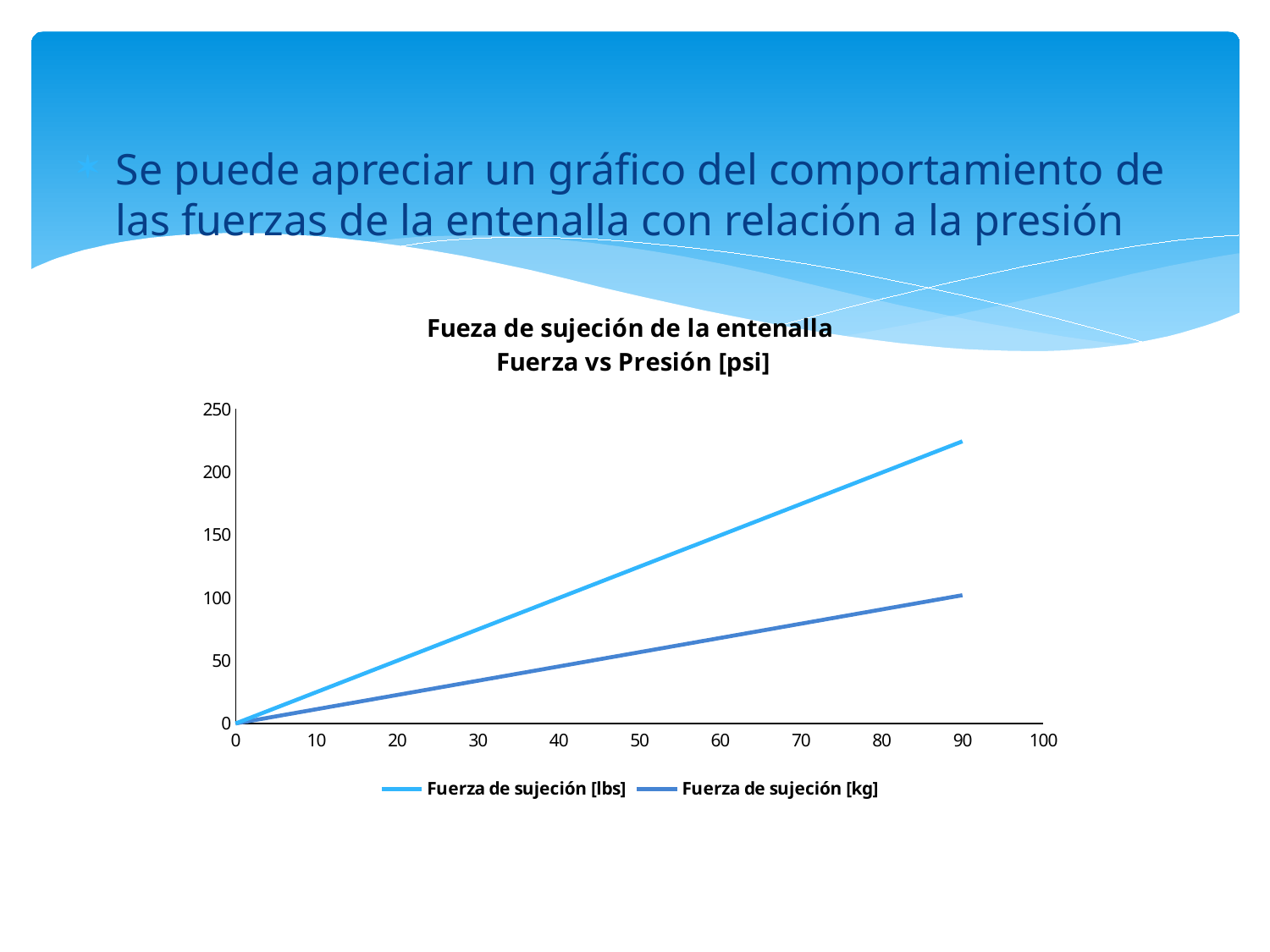
What is the value of Fuerza de sujeción [lbs] at 0 psi? 0 Do the values of Fuerza de sujeción [kg] rise or fall as pressure increases along the x axis? rise Which series is drawn in the lighter blue line? Fuerza de sujeción [lbs] What kind of chart is shown on the slide? line chart Is the value of Fuerza de sujeción [lbs] at 90 psi greater or less than 200? greater Is the value of Fuerza de sujeción [kg] at 50 psi greater or less than 100? less Do the values of Fuerza de sujeción [lbs] rise or fall as pressure increases along the x axis? rise At 90 psi, which series has the larger value, Fuerza de sujeción [lbs] or Fuerza de sujeción [kg]? Fuerza de sujeción [lbs] Is the value of Fuerza de sujeción [lbs] at 50 psi greater or less than 100? greater How many series does the chart legend list? 2 What is the title of the chart? Fueza de sujeción de la entenalla Fuerza vs Presión [psi]